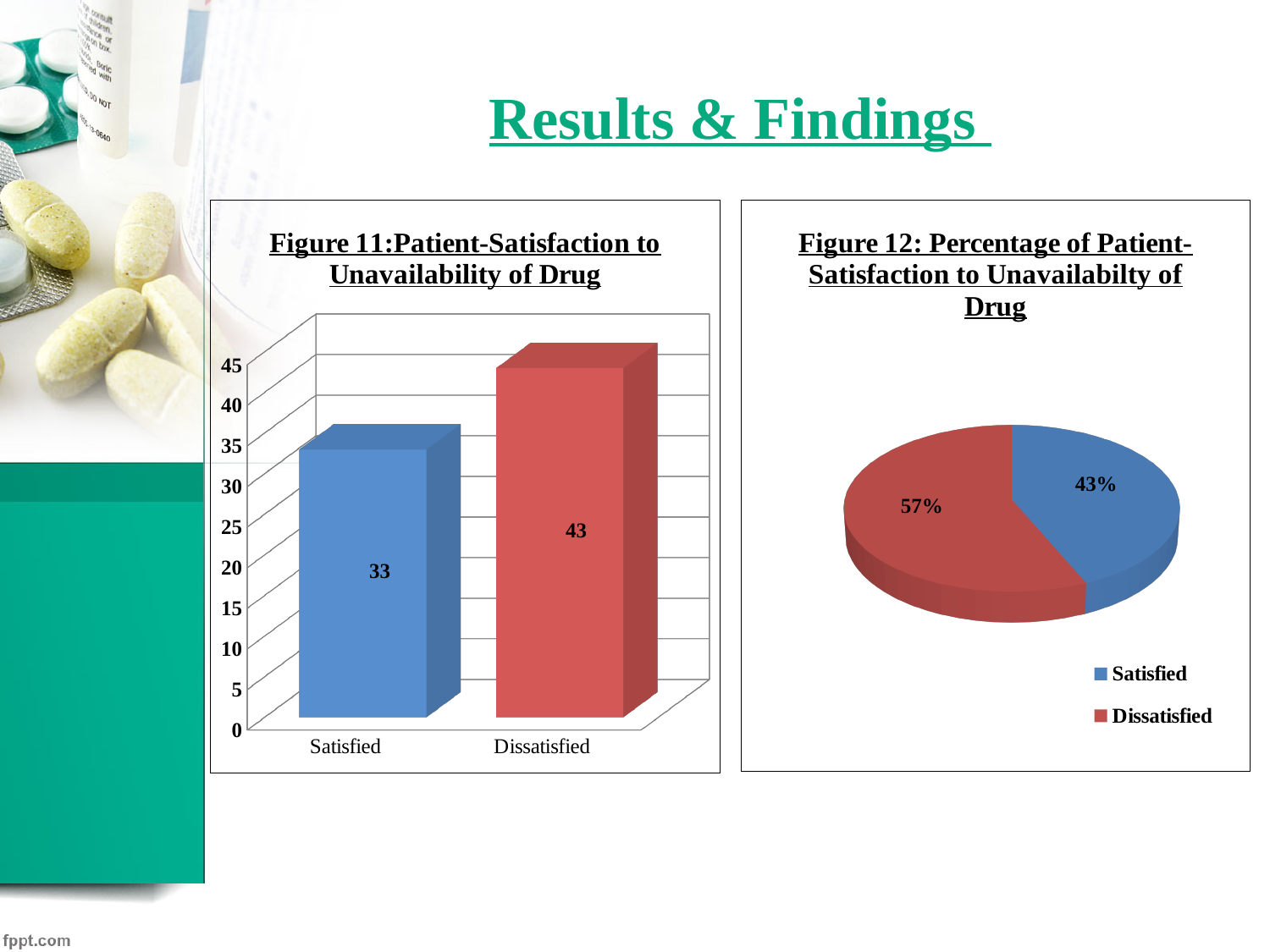
In Figure 12, how many entries does the legend list? 2 In Figure 12, what percentage is shown for Satisfied? 43% In Figure 12, what percentage is shown for Dissatisfied? 57% In Figure 11, what is the difference between the Dissatisfied and Satisfied values? 10 In Figure 11, how many categories are shown on the x axis? 2 In Figure 12, which slice is larger, Satisfied or Dissatisfied? Dissatisfied In Figure 11, which category has the lowest value? Satisfied In Figure 11, what is the value for Satisfied? 33 In Figure 11, what is the value for Dissatisfied? 43 What kind of chart is Figure 11? Bar chart In Figure 11, which category has the highest value? Dissatisfied What kind of chart is Figure 12? Pie chart